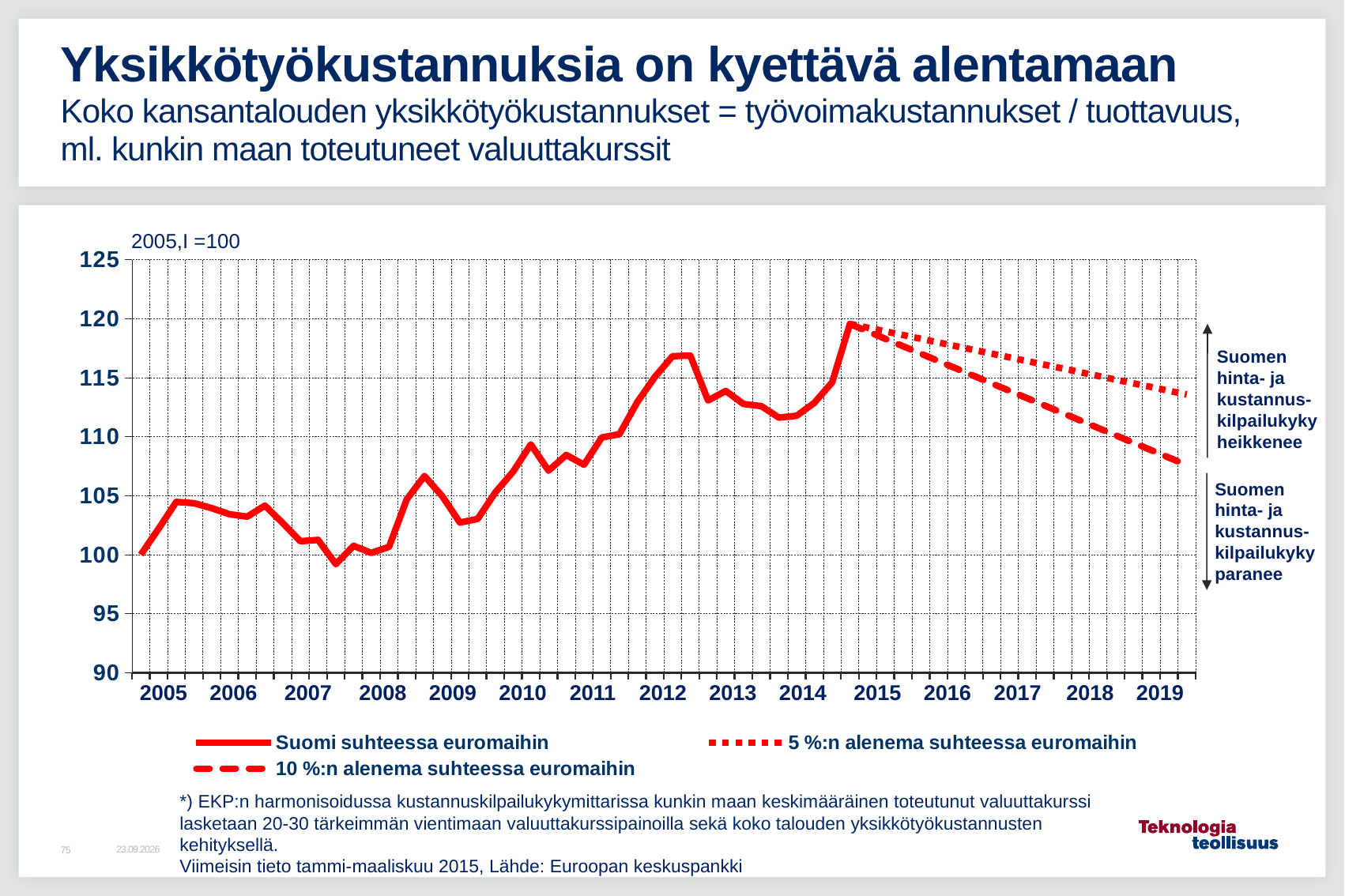
Is the value of the 'Suomi suhteessa euromaihin' series at the start of 2015 greater or less than 115? greater At the end of the chart in 2019, which series is higher: '5 %:n alenema suhteessa euromaihin' or '10 %:n alenema suhteessa euromaihin'? 5 %:n alenema suhteessa euromaihin What is the index value of the 'Suomi suhteessa euromaihin' series at the start of 2005? 100 Is the value of the '10 %:n alenema suhteessa euromaihin' series at its end in 2019 greater or less than 110? less Does the 'Suomi suhteessa euromaihin' series overall rise or fall between 2005 and 2015? rise Is the value of the 'Suomi suhteessa euromaihin' series at the start of 2013 greater or less than 110? greater How many series does the legend list? 3 Do the two projection series (5 % and 10 % alenema) rise or fall from 2015 to 2019? fall Which series is drawn as a solid red line in the legend? Suomi suhteessa euromaihin What kind of chart is shown on the slide? line chart What base period and value is the index set to, according to the note above the chart? 2005,I =100